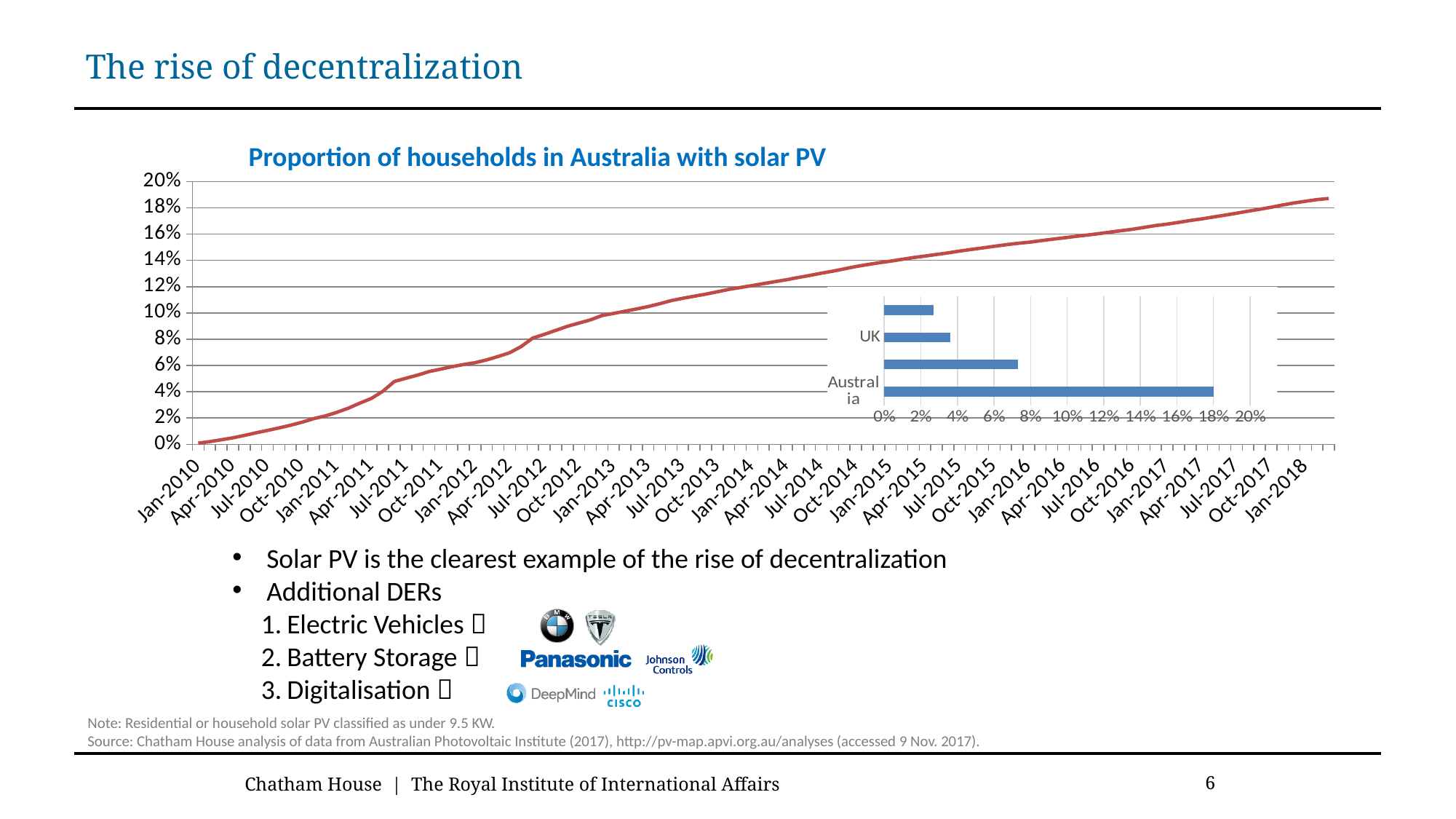
In the line chart 'Proportion of households in Australia with solar PV', is the value for Jan-2017 greater or less than 16%? greater What is the title of the line chart on the slide? Proportion of households in Australia with solar PV In the line chart 'Proportion of households in Australia with solar PV', does the value rise or fall from Jan-2010 to Jan-2018? rise What kind of chart is the large chart titled 'Proportion of households in Australia with solar PV'? line chart What kind of chart is the small inset chart on the right side of the slide? bar chart In the line chart 'Proportion of households in Australia with solar PV', what is the highest value shown on the vertical axis? 20% In the inset bar chart, is the value for UK greater or less than 6%? less In the inset bar chart, is the value for Australia greater or less than 16%? greater In the inset bar chart, which of the labelled countries, UK or Australia, has the larger value? Australia